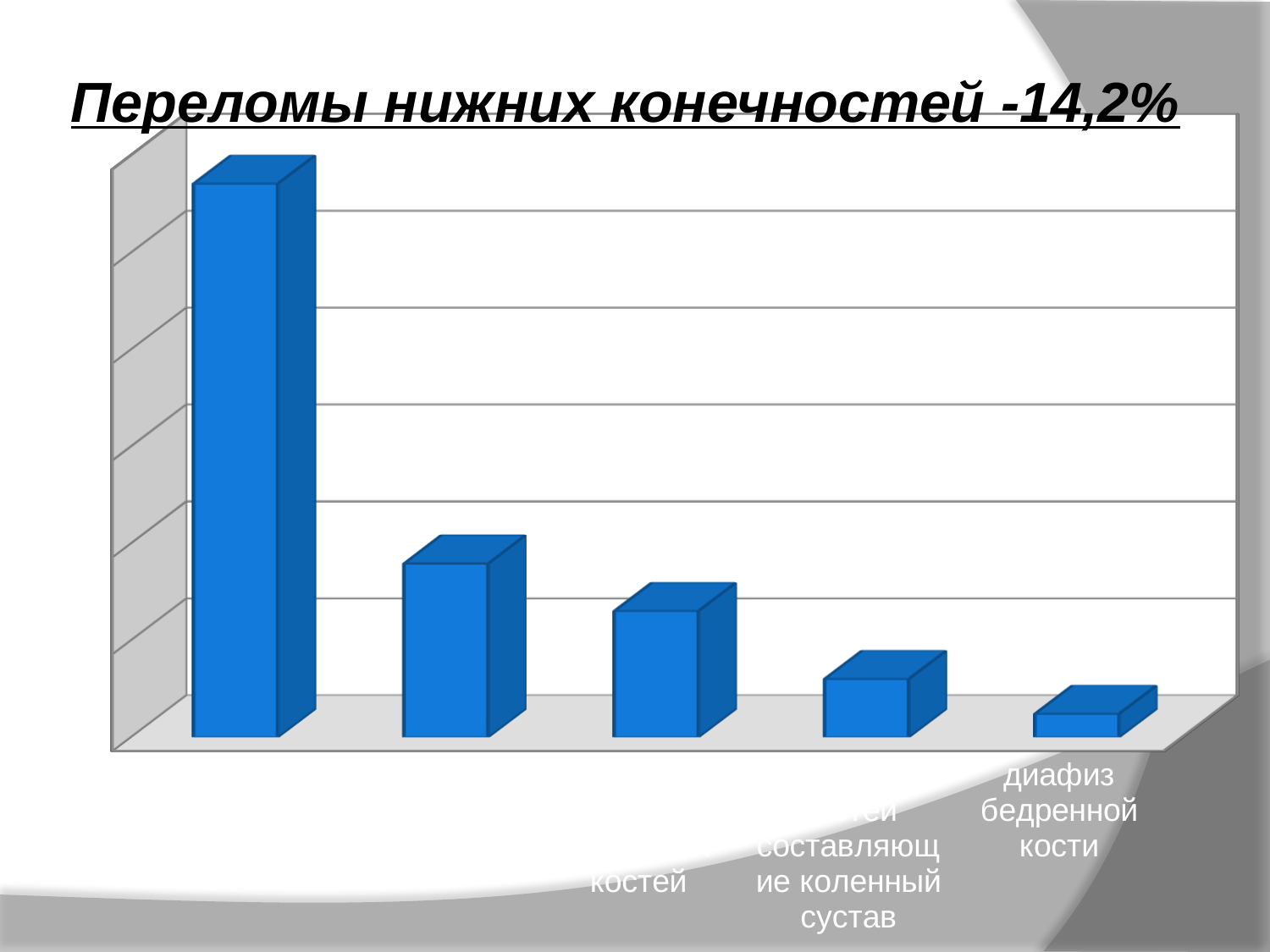
Is the fourth bar from the left taller or shorter than the bar for 'диафиз бедренной кости'? taller Which bar is the tallest in the chart: the first (leftmost) or the last (rightmost)? the first (leftmost) What is the title of the slide above the chart? Переломы нижних конечностей -14,2% Do the bar heights rise or fall from left to right across the chart? fall Which category has the lowest bar in the chart? диафиз бедренной кости How many bars does the chart contain? 5 Is the second bar from the left taller or shorter than the third bar from the left? taller What kind of chart is shown on the slide? bar chart Is the bar for 'диафиз бедренной кости' taller or shorter than the leftmost bar? shorter What colour are the bars in the chart? blue Which position does the bar labelled 'диафиз бедренной кости' occupy in the chart? rightmost (last)